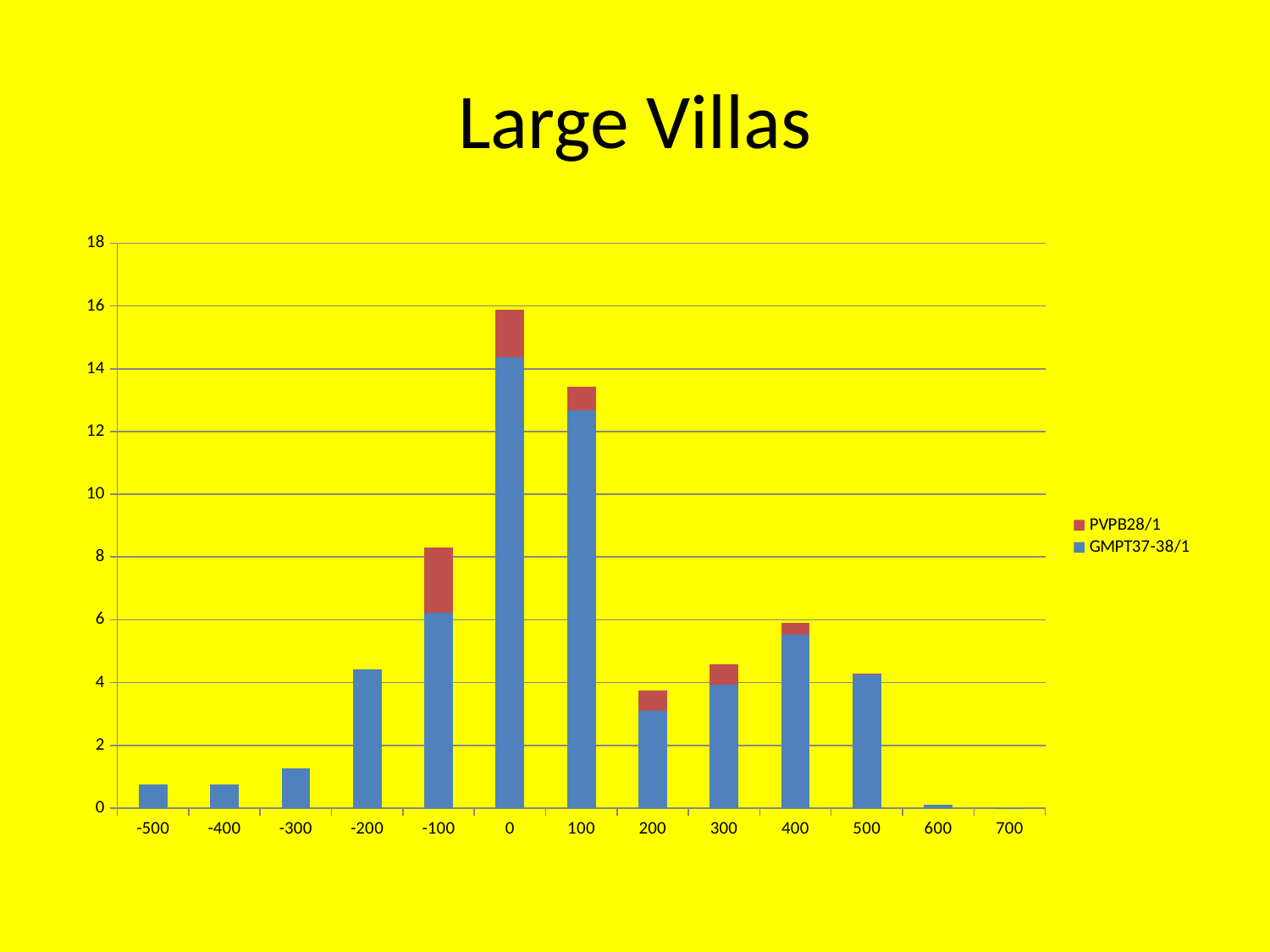
What kind of chart is shown on the slide? stacked bar chart Is the total stacked value for category 100 greater or less than 12? greater Do the bar heights rise or fall from category -500 to category 0? rise How many series does the legend list? 2 Is the total stacked value for category 0 greater or less than 14? greater Is the value for category -300 greater or less than 2? less What is the title of the chart? Large Villas Which series is shown in red in the legend? PVPB28/1 Which has the taller stacked bar, category 300 or category 200? 300 Which category has the tallest stacked bar? 0 How many categories are shown on the x axis? 13